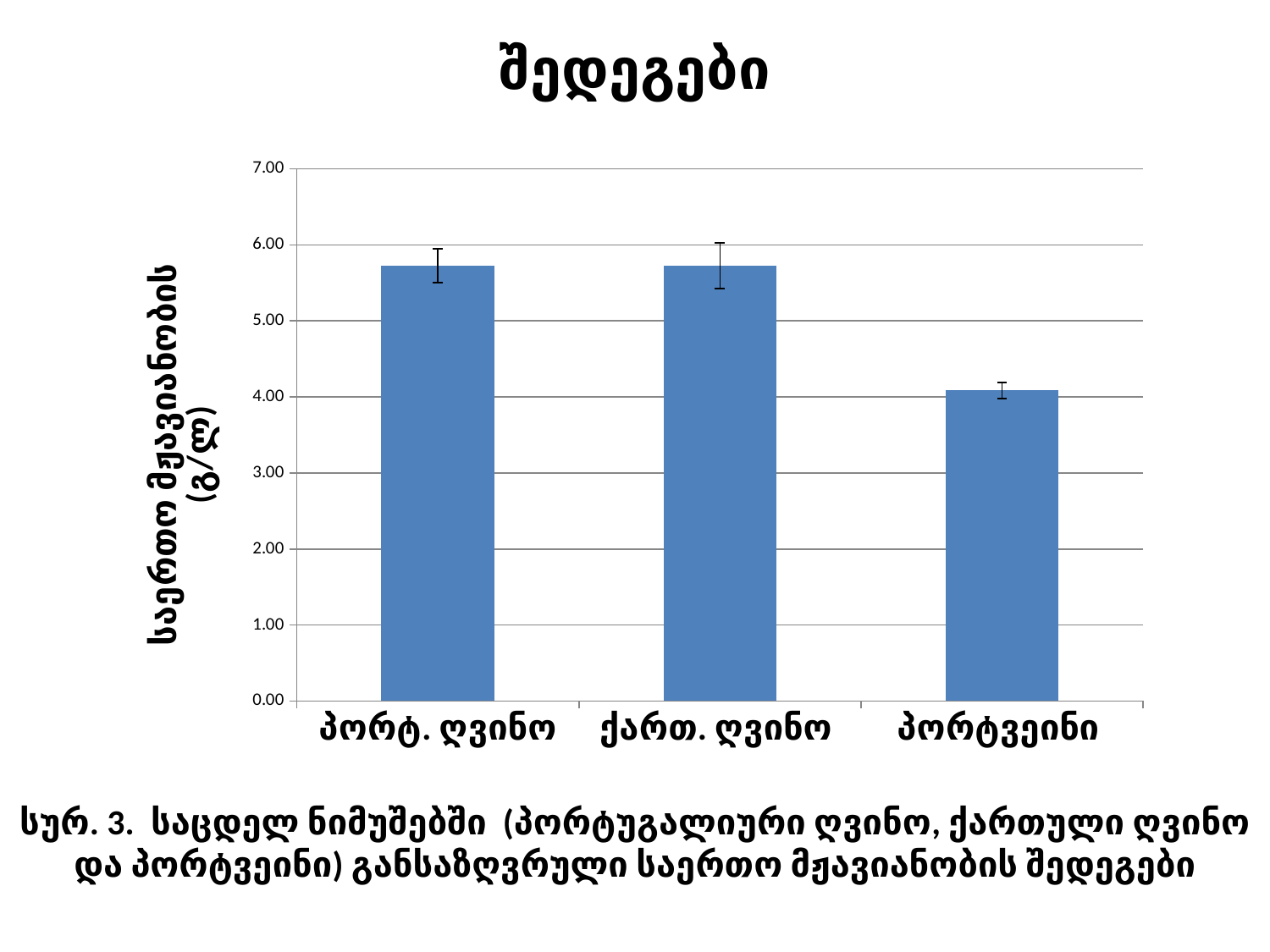
Which category has the lowest value in the chart? პორტვეინი Which is larger, the value for პორტ. ღვინო or the value for პორტვეინი? პორტ. ღვინო What is the label of the vertical axis? საერთო მჟავიანობის (გ/ლ) What kind of chart is shown on the slide? bar chart How many categories are plotted in the chart? 3 Is the value for პორტვეინი greater or less than 5.00? less Is the value for პორტ. ღვინო greater or less than 6.00? less Which is larger, the value for ქართ. ღვინო or the value for პორტვეინი? ქართ. ღვინო Is the value for ქართ. ღვინო greater or less than 6.00? less What is the title shown above the chart? შედეგები